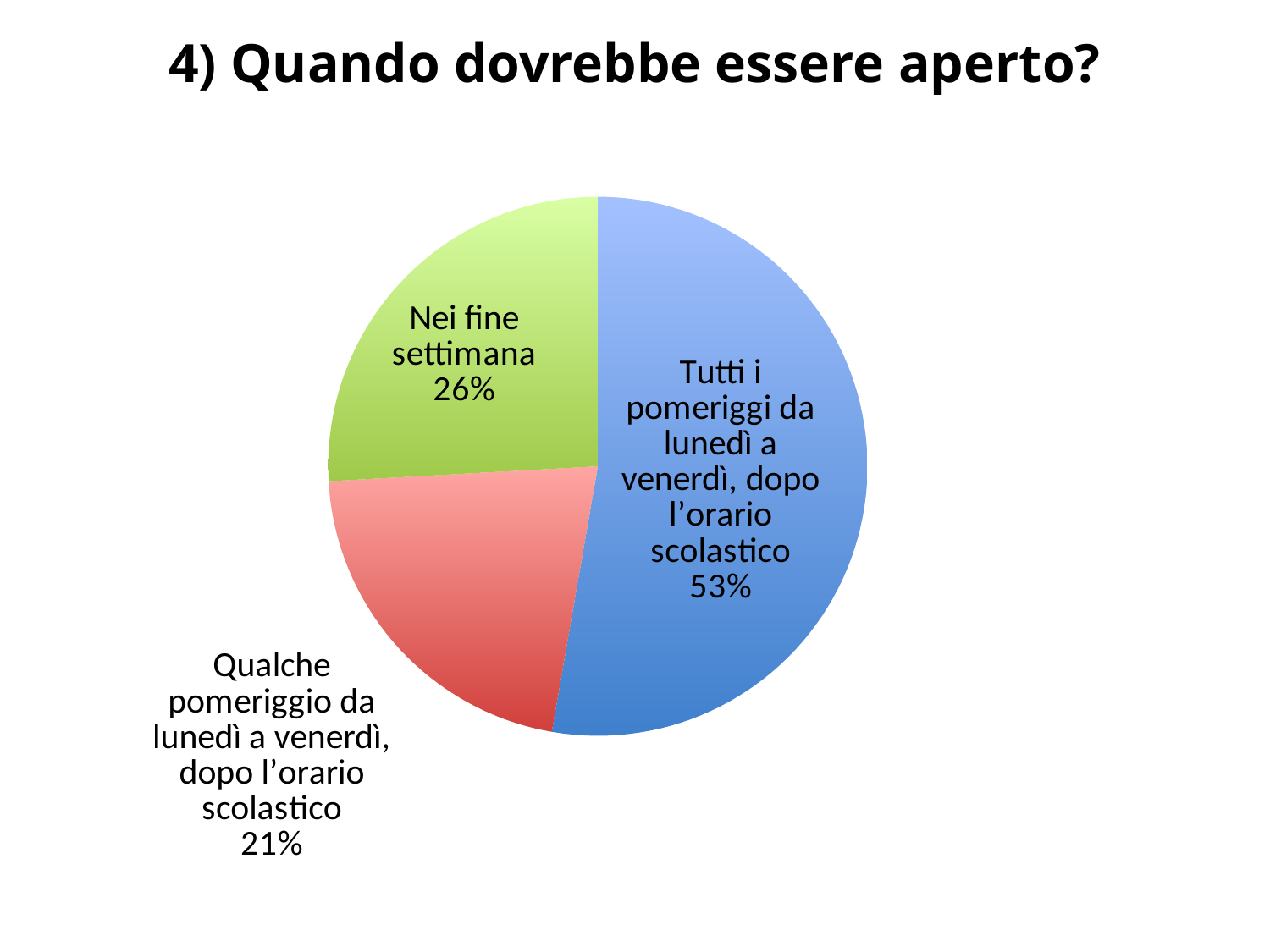
What colour is the slice for "Nei fine settimana"? green What share of the pie does "Tutti i pomeriggi da lunedì a venerdì, dopo l'orario scolastico" represent? 53% What is the difference in percentage points between "Nei fine settimana" and "Qualche pomeriggio da lunedì a venerdì, dopo l'orario scolastico"? 5 percentage points Which category has the smallest slice of the pie? Qualche pomeriggio da lunedì a venerdì, dopo l'orario scolastico Which is larger: the share for "Nei fine settimana" or the share for "Qualche pomeriggio da lunedì a venerdì, dopo l'orario scolastico"? Nei fine settimana Which category has the largest slice of the pie? Tutti i pomeriggi da lunedì a venerdì, dopo l'orario scolastico What is the difference in percentage points between "Tutti i pomeriggi da lunedì a venerdì, dopo l'orario scolastico" and "Nei fine settimana"? 27 percentage points How many slices does the pie chart have? 3 What kind of chart is shown on the slide? pie chart What share of the pie does "Nei fine settimana" represent? 26% What is the title of the slide? 4) Quando dovrebbe essere aperto? What share of the pie does "Qualche pomeriggio da lunedì a venerdì, dopo l'orario scolastico" represent? 21%